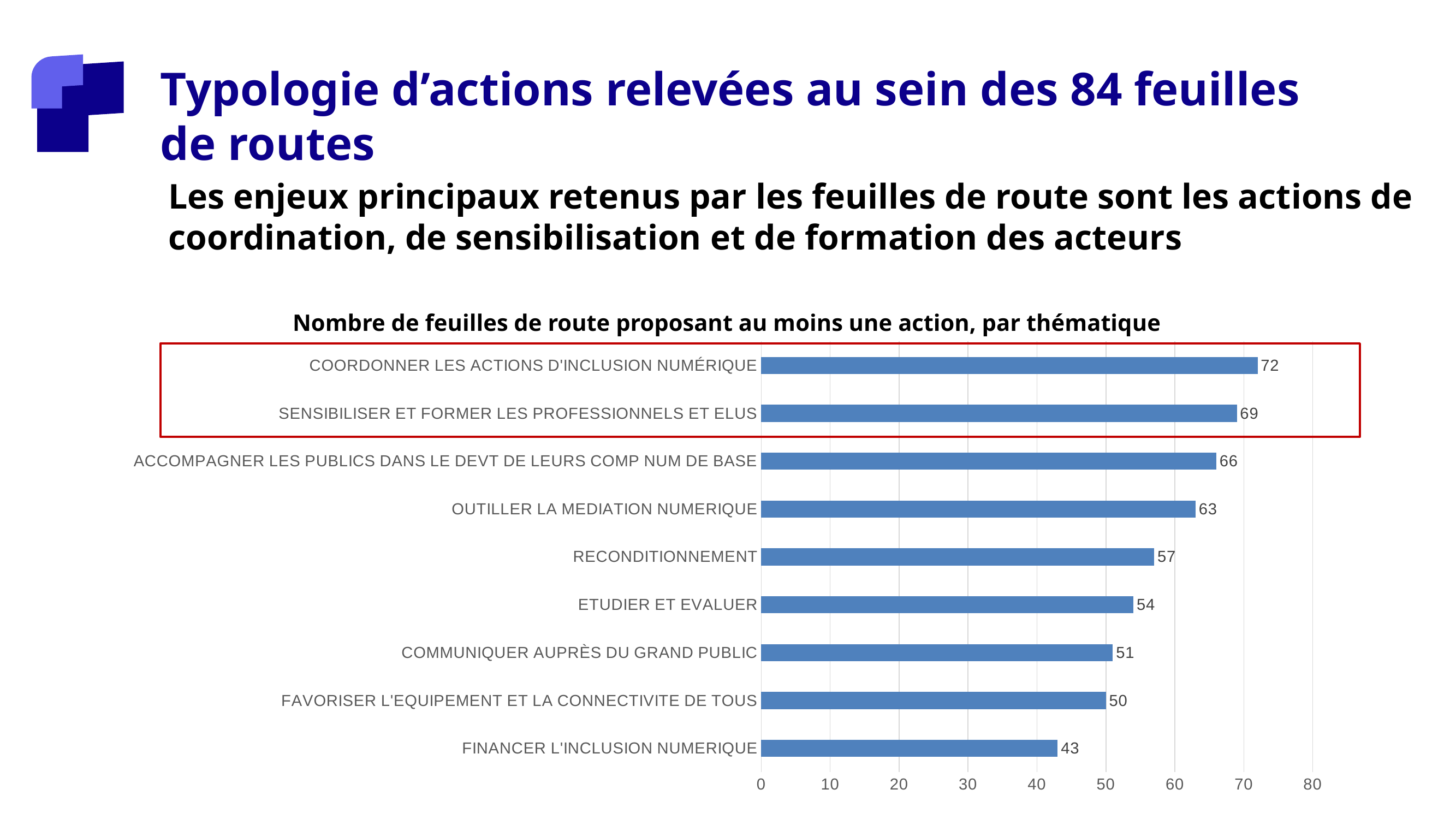
What is the value for COORDONNER LES ACTIONS D'INCLUSION NUMÉRIQUE? 72 What kind of chart is shown on the slide? bar chart Which category has the highest value? COORDONNER LES ACTIONS D'INCLUSION NUMÉRIQUE How many categories are shown in the chart? 9 What is the value for RECONDITIONNEMENT? 57 What is the difference between the values for OUTILLER LA MEDIATION NUMERIQUE and FINANCER L'INCLUSION NUMERIQUE? 20 What is the title of the chart? Nombre de feuilles de route proposant au moins une action, par thématique Is the value for ACCOMPAGNER LES PUBLICS DANS LE DEVT DE LEURS COMP NUM DE BASE greater or less than 60? greater What is the value for FINANCER L'INCLUSION NUMERIQUE? 43 What is the difference between the values for COORDONNER LES ACTIONS D'INCLUSION NUMÉRIQUE and SENSIBILISER ET FORMER LES PROFESSIONNELS ET ELUS? 3 Which category has the lowest value? FINANCER L'INCLUSION NUMERIQUE Which is larger: the value for ETUDIER ET EVALUER or the value for COMMUNIQUER AUPRÈS DU GRAND PUBLIC? ETUDIER ET EVALUER